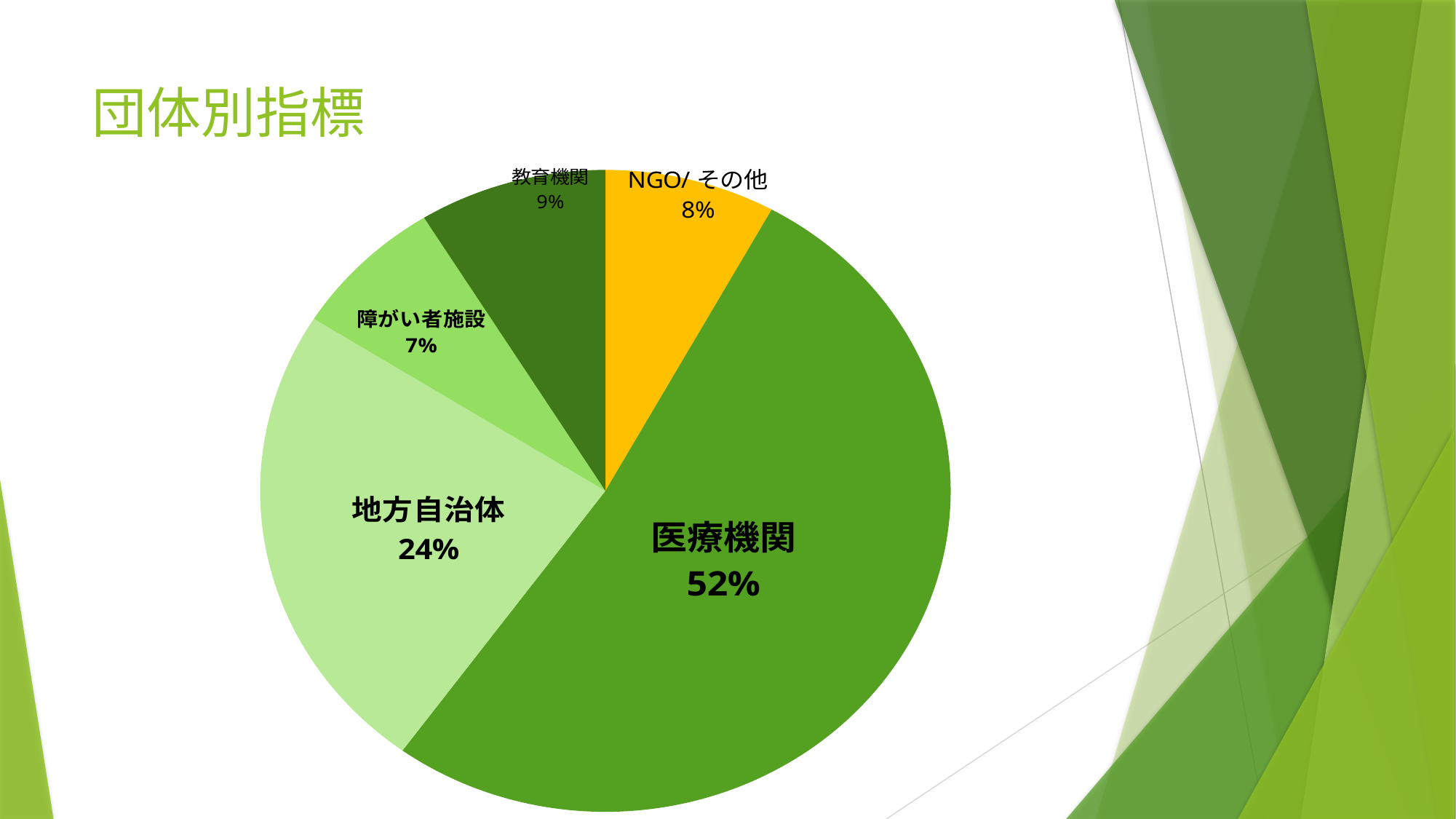
Which category has the smallest slice of the pie? 障がい者施設 Which category has the largest slice of the pie? 医療機関 Which is larger, the share for 教育機関 or the share for NGO/ その他? 教育機関 How many categories are shown in the pie chart? 5 What is the value shown for 教育機関? 9% What share of the pie does 地方自治体 hold? 24% What share of the pie does 医療機関 hold? 52% What is the difference between the shares of 医療機関 and 地方自治体? 28% What kind of chart is shown on the slide? Pie chart What is the value shown for 障がい者施設? 7% What is the value shown for NGO/ その他? 8% What is the title of the slide containing the chart? 団体別指標